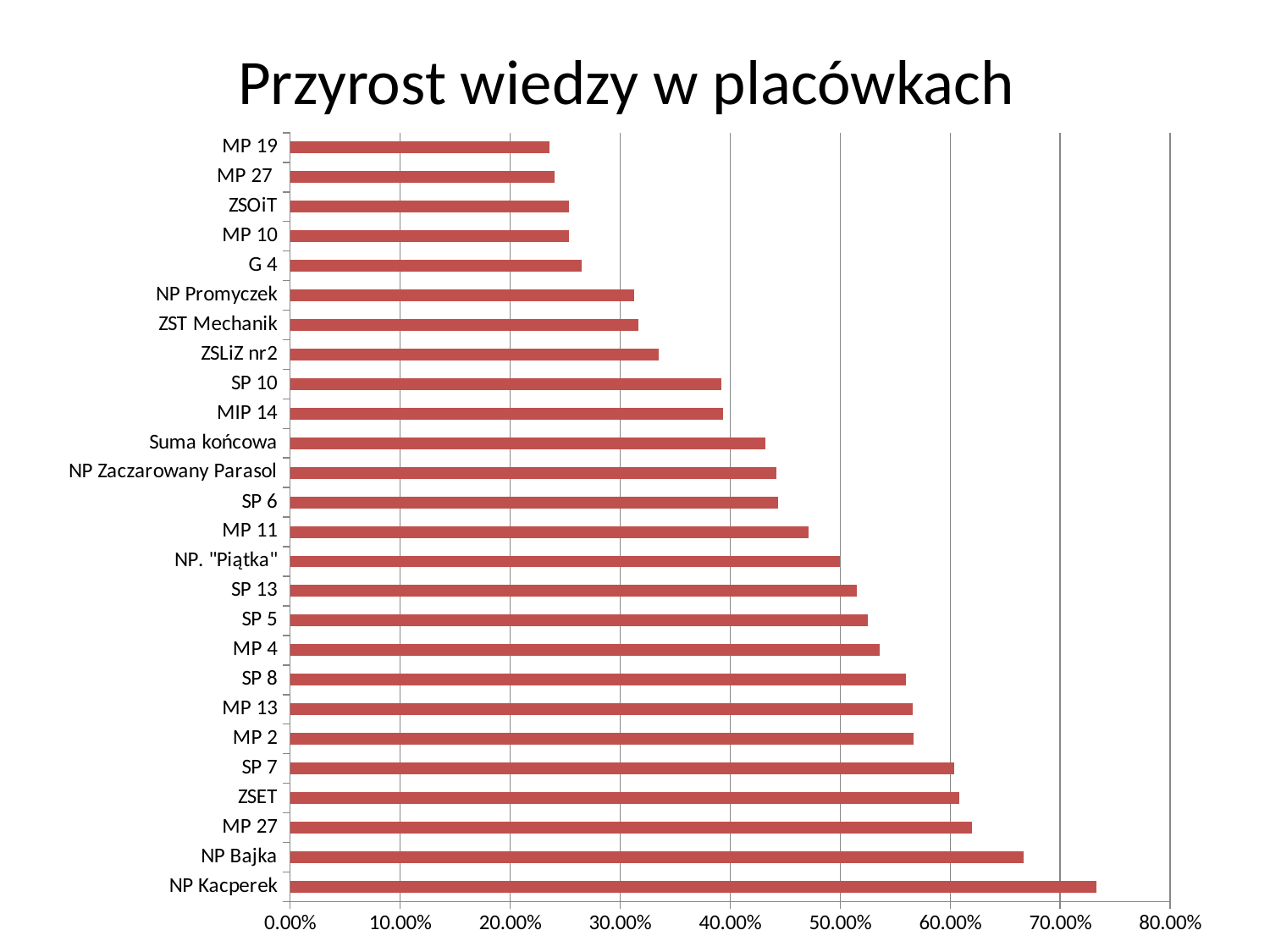
Which has a larger value, NP Bajka or SP 7? NP Bajka Is the value for MP 19 greater or less than 30.00%? less Is the value for NP Bajka greater or less than 60.00%? greater What is the title of the chart? Przyrost wiedzy w placówkach What kind of chart is shown on the slide? bar chart Which category has the highest value? NP Kacperek Is the value for SP 8 greater or less than 50.00%? greater How many bars are plotted in the chart? 26 Which has a larger value, MP 19 or SP 13? SP 13